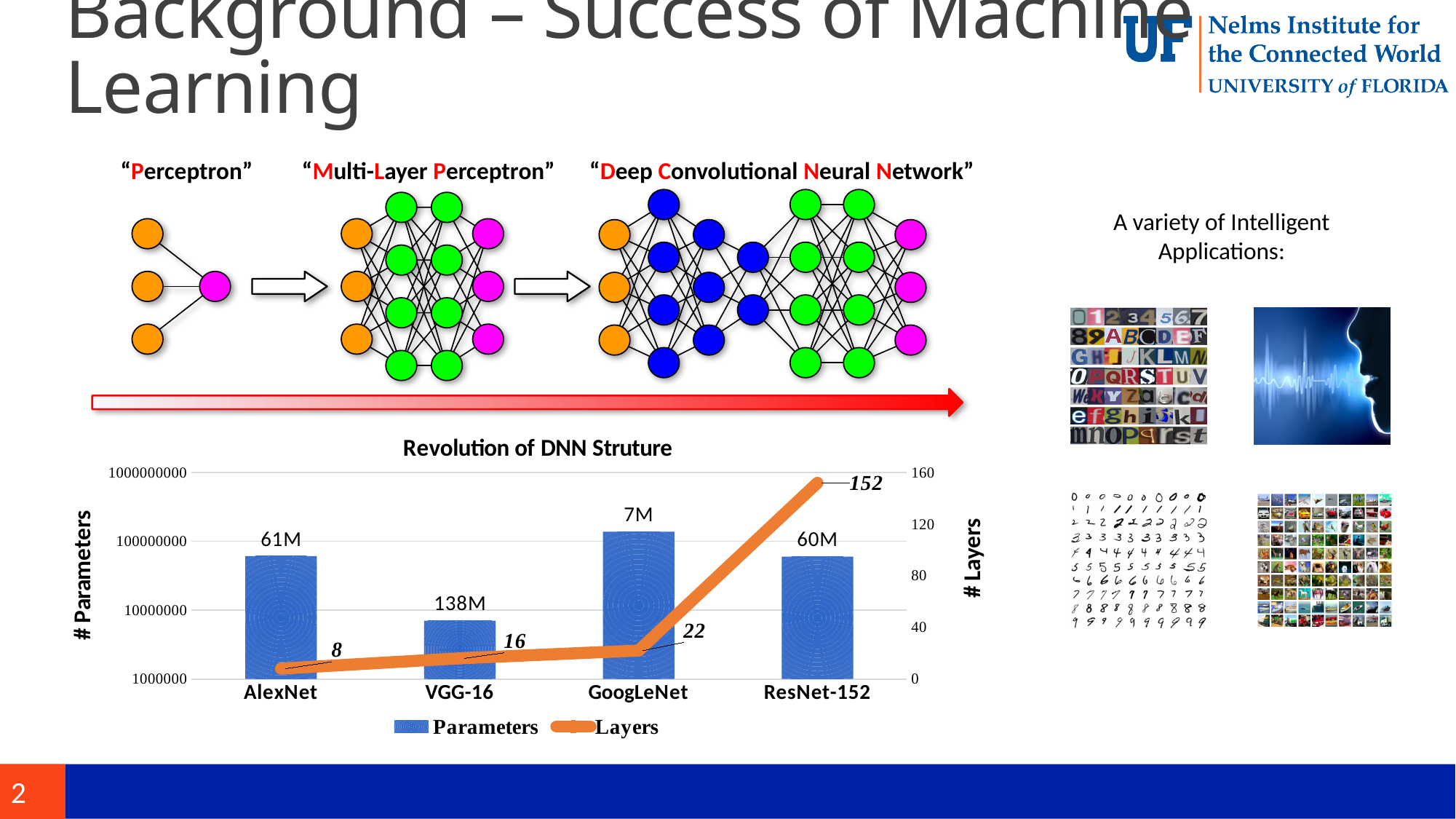
In the 'Revolution of DNN Struture' chart, which network has the highest number of layers? ResNet-152 In the 'Revolution of DNN Struture' chart, what is the Parameters data label for VGG-16? 138M How many networks are shown on the x axis of the 'Revolution of DNN Struture' chart? 4 In the 'Revolution of DNN Struture' chart, how many layers does VGG-16 have? 16 In the 'Revolution of DNN Struture' chart, do the Layers values rise or fall from AlexNet to ResNet-152? rise In the 'Revolution of DNN Struture' chart, what is the Parameters data label for AlexNet? 61M In the 'Revolution of DNN Struture' chart, which network has the lowest number of layers? AlexNet In the 'Revolution of DNN Struture' chart, what is the difference in layers between ResNet-152 and GoogLeNet? 130 In the 'Revolution of DNN Struture' chart, which has more layers, VGG-16 or AlexNet? VGG-16 In the 'Revolution of DNN Struture' chart, what is the Parameters data label for ResNet-152? 60M How many series does the legend of the 'Revolution of DNN Struture' chart list? 2 In the 'Revolution of DNN Struture' chart, how many layers does GoogLeNet have according to the Layers line? 22